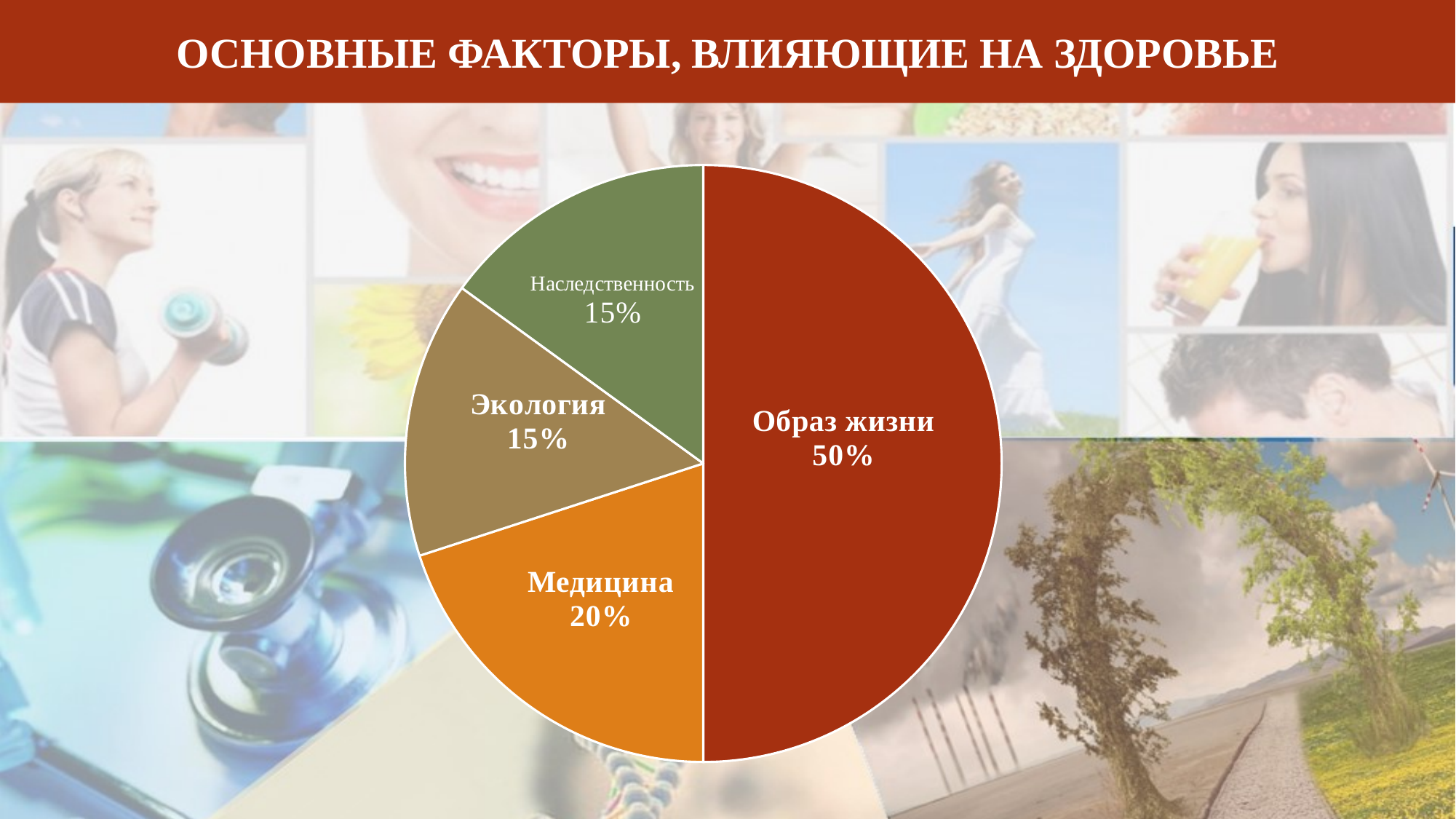
What colour is the Медицина slice of the pie? orange What is the difference between the shares of Образ жизни and Медицина? 30% Which is larger, the share of Медицина or the share of Экология? Медицина What is the combined share of Экология and Наследственность? 30% What share of the pie does Образ жизни have? 50% How many slices does the pie chart have? 4 Which slice of the pie is the largest? Образ жизни What share of the pie does Медицина have? 20% What kind of chart is shown on the slide? pie chart What is the title of the slide containing the pie chart? ОСНОВНЫЕ ФАКТОРЫ, ВЛИЯЮЩИЕ НА ЗДОРОВЬЕ What share of the pie does Экология have? 15% What share of the pie does Наследственность have? 15%